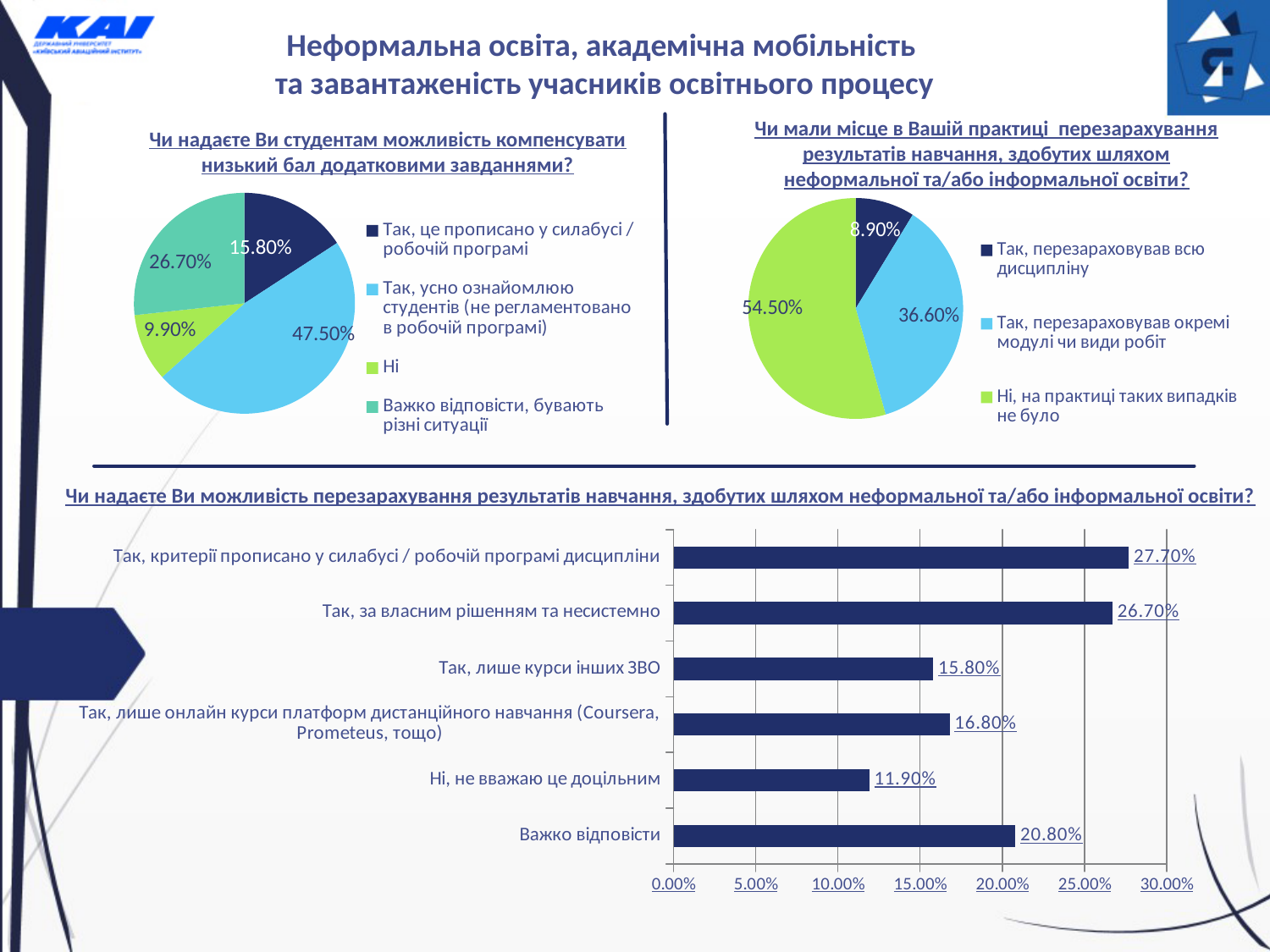
In the top-left pie chart (about compensating a low score with additional tasks), which answer has the smallest share? Ні In the top-left pie chart (about compensating a low score with additional tasks), what is the difference between the shares for "Важко відповісти, бувають різні ситуації" and "Так, це прописано у силабусі / робочій програмі"? 10.90% In the top-right pie chart (about recognising results of non-formal/informal education in practice), which answer has the largest share? Ні, на практиці таких випадків не було In the top-right pie chart (about recognising results of non-formal/informal education in practice), what share answered "Ні, на практиці таких випадків не було"? 54.50% In the bottom bar chart, how many categories are shown? 6 In the top-right pie chart (about recognising results of non-formal/informal education in practice), how many entries does the legend list? 3 What type of chart is the bottom chart on the slide ("Чи надаєте Ви можливість перезарахування результатів навчання...")? Bar chart In the bottom bar chart, which is larger: the value for "Важко відповісти" or the value for "Ні, не вважаю це доцільним"? Важко відповісти In the bottom bar chart, which category has the highest value? Так, критерії прописано у силабусі / робочій програмі дисципліни In the top-left pie chart (about compensating a low score with additional tasks), how many slices does the pie have? 4 In the top-left pie chart (about compensating a low score with additional tasks), what share of respondents answered "Так, усно ознайомлюю студентів (не регламентовано в робочій програмі)"? 47.50% In the bottom bar chart, what is the value for "Так, лише онлайн курси платформ дистанційного навчання (Coursera, Prometeus, тощо)"? 16.80%